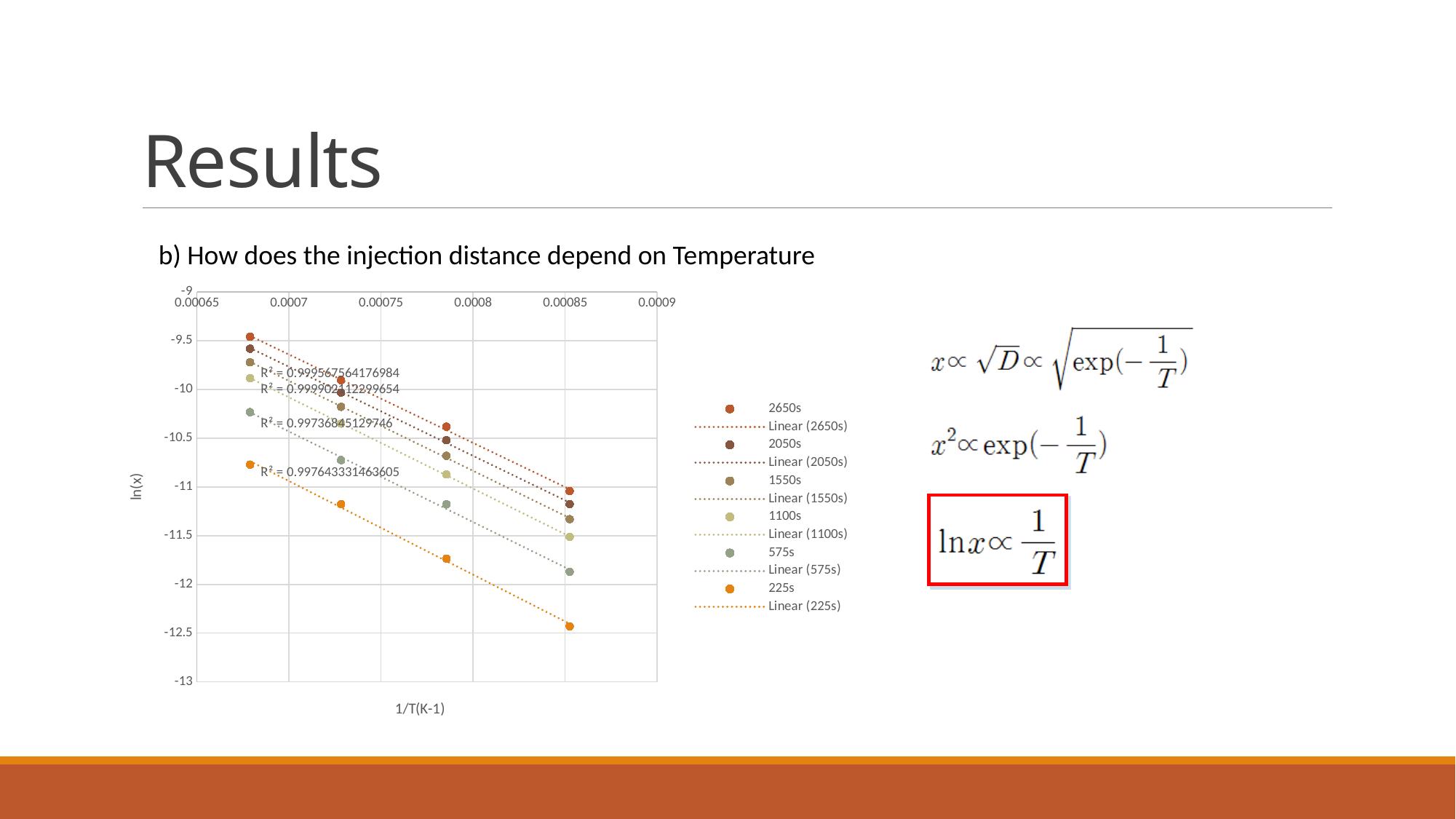
How many data series (excluding the linear trendlines) are plotted on the chart? 6 What is the label of the y axis of the chart? ln(x) At 1/T = 0.00085, which series has the larger ln(x) value, 2650s or 225s? 2650s Is the ln(x) value for the 225s series at 1/T = 0.00085 greater or less than -12? less What kind of chart is shown on the slide? scatter chart How many data points are plotted for the 225s series? 4 What is the label of the x axis of the chart? 1/T(K-1) Is the ln(x) value for the 2650s series at 1/T = 0.00085 greater or less than -11.5? greater Which series has the highest ln(x) values on the chart? 2650s How many entries does the chart legend list? 12 Which series has the lowest ln(x) values on the chart? 225s Do the ln(x) values rise or fall as 1/T increases along the x axis? fall